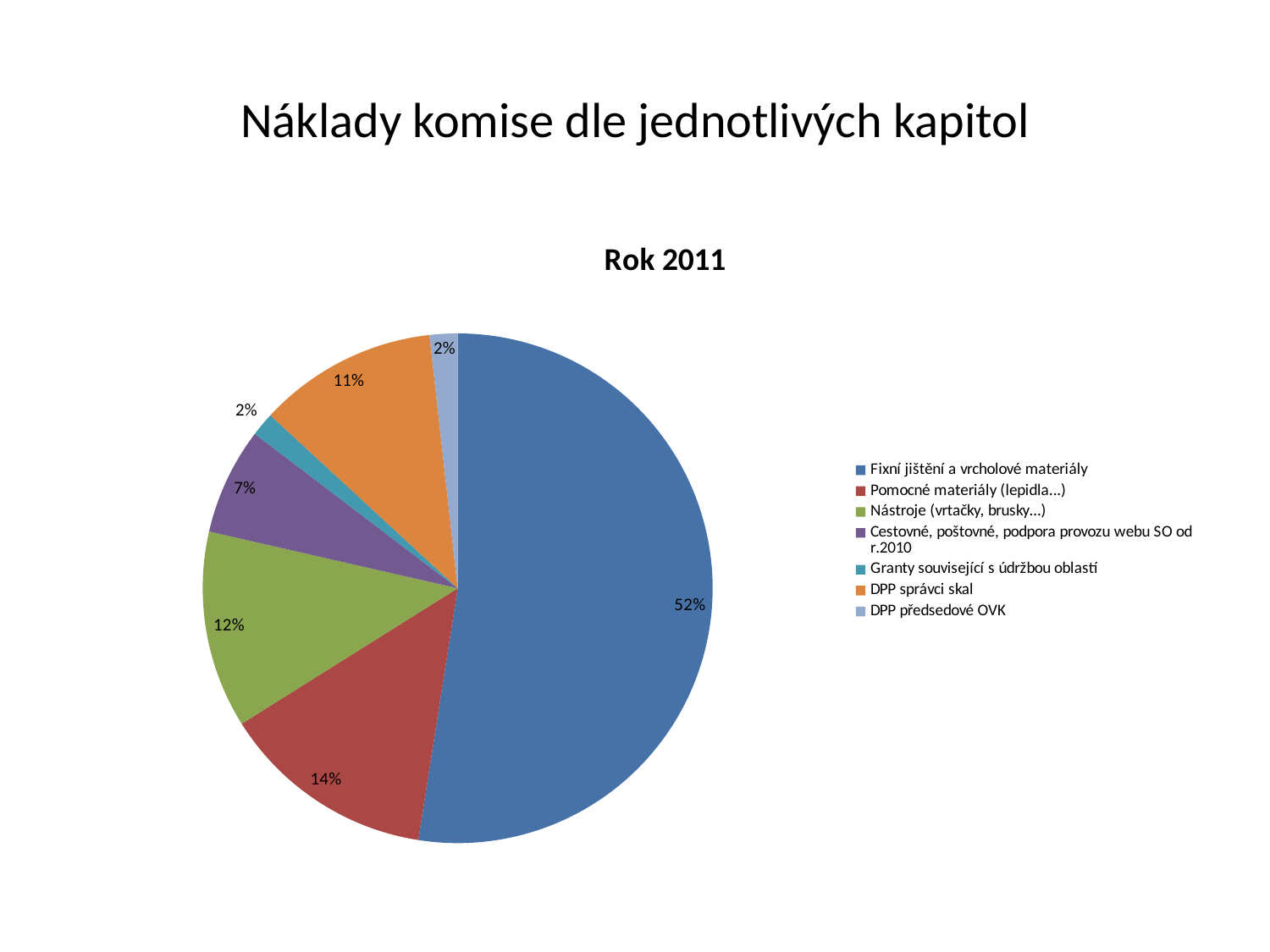
Which category has the largest share of the pie? Fixní jištění a vrcholové materiály What share of the pie is Pomocné materiály (lepidla...)? 14% What share of the pie is Fixní jištění a vrcholové materiály? 52% What colour is the slice for DPP správci skal? orange How many slices does the pie chart have? 7 What share of the pie is Cestovné, poštovné, podpora provozu webu SO od r.2010? 7% Which is larger, the share for Nástroje (vrtačky, brusky...) or the share for DPP správci skal? Nástroje (vrtačky, brusky...) What is the difference in percentage points between the share for Fixní jištění a vrcholové materiály and the share for Pomocné materiály (lepidla...)? 38 What is the title of the chart? Rok 2011 What kind of chart is shown on the slide? pie chart